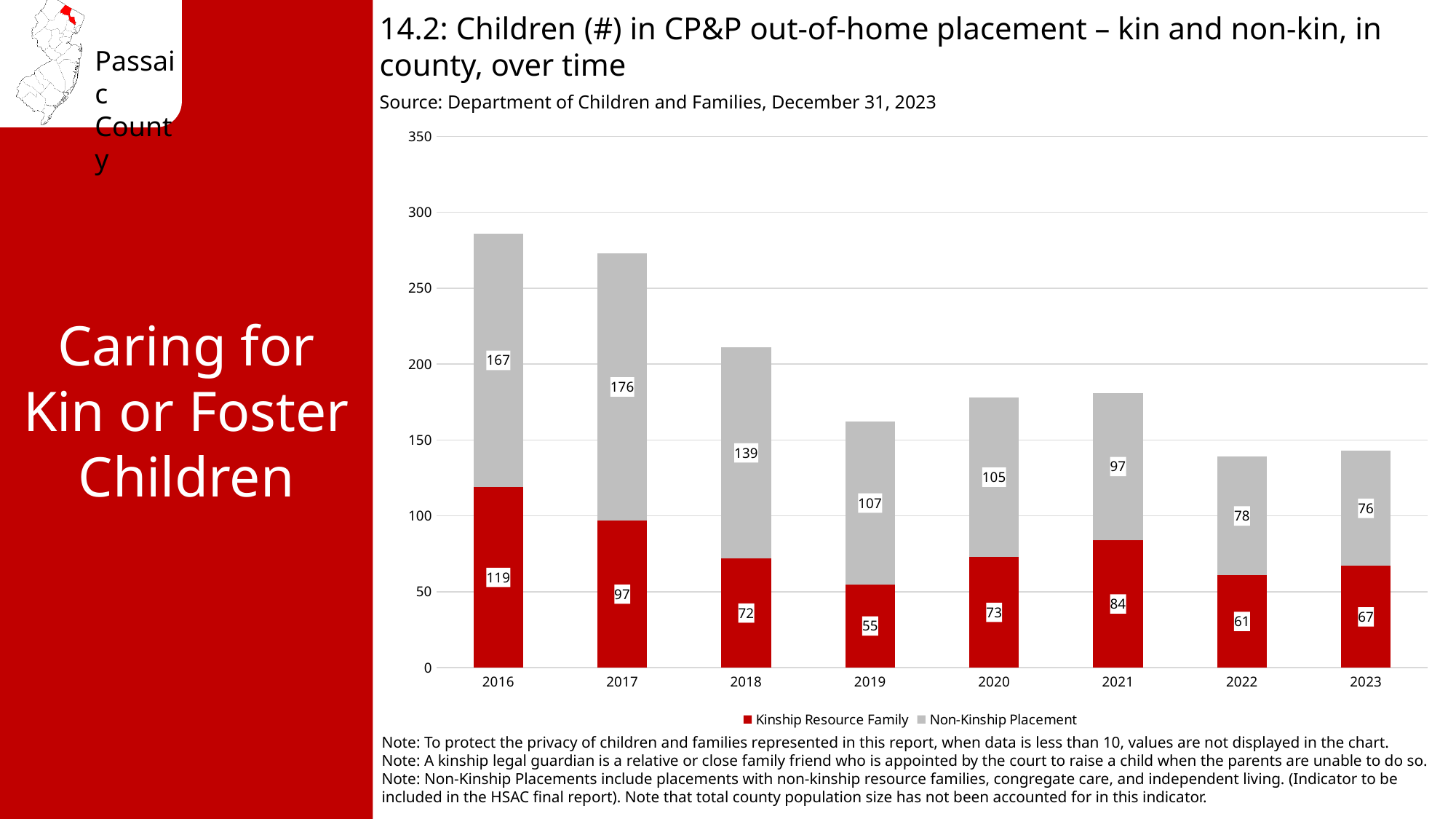
Which year has the highest Non-Kinship Placement value? 2017 How many series does the legend list? 2 Which is larger, the Kinship Resource Family value in 2021 or in 2022? 2021 What is the total of the stacked bar for 2016? 286 What is the value for Kinship Resource Family in 2016? 119 How many years are shown on the x axis? 8 What is the value for Kinship Resource Family in 2019? 55 What is the total of the stacked bar for 2022? 139 What is the value for Non-Kinship Placement in 2023? 76 Which year has the lowest Kinship Resource Family value? 2019 What is the value for Non-Kinship Placement in 2017? 176 What is the difference between the Non-Kinship Placement values in 2016 and 2023? 91